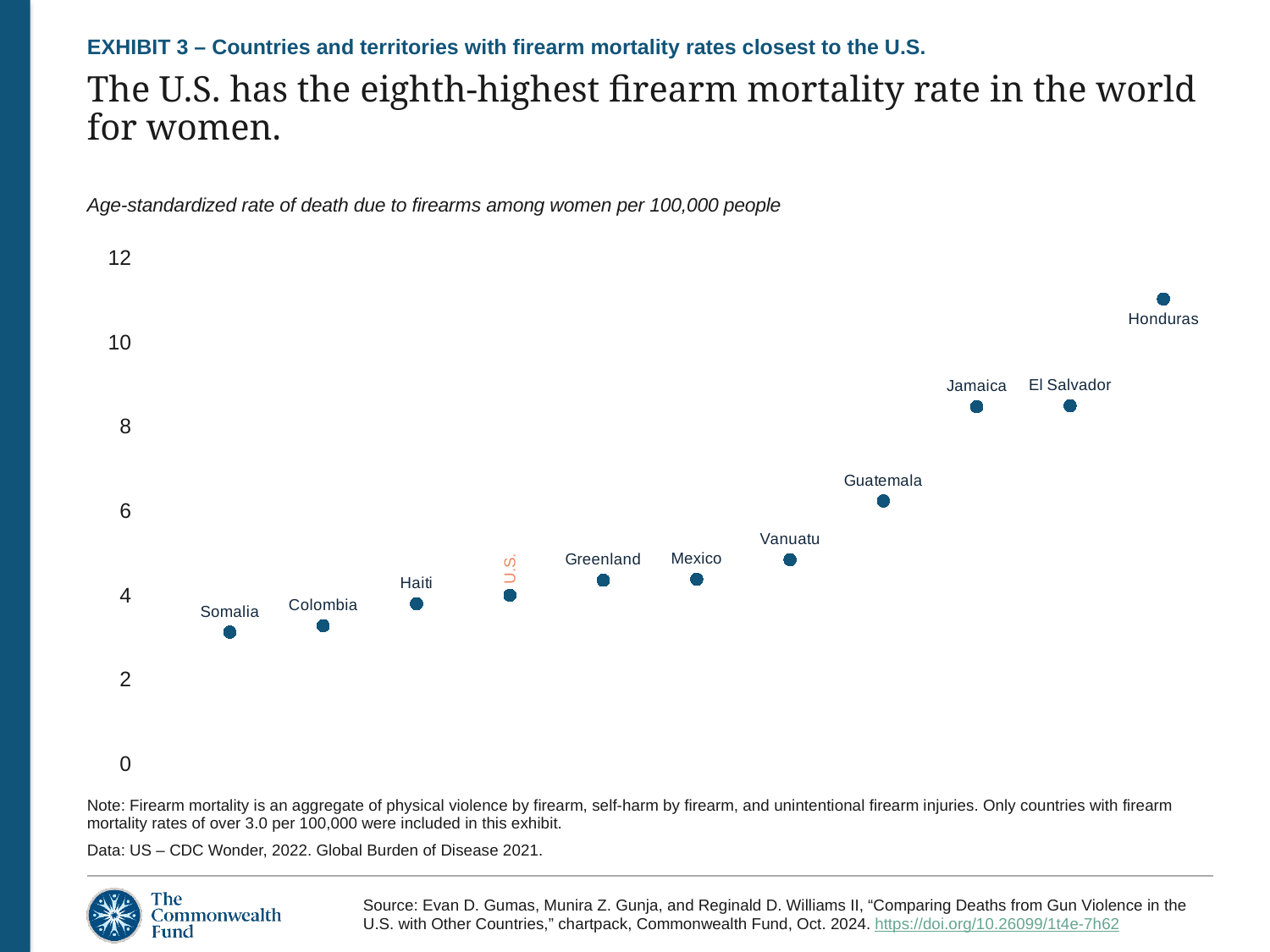
Is the value for Guatemala greater or less than 8? less Which country has the highest firearm mortality rate for women on the chart? Honduras Which has a higher firearm mortality rate for women, Guatemala or Vanuatu? Guatemala What kind of chart is shown on the slide? Scatter (dot) chart Which has a higher firearm mortality rate for women, Jamaica or Colombia? Jamaica How many countries and territories are plotted on the chart? 11 Is the value for Somalia greater or less than 4? less Is the value for Honduras greater or less than 10? greater What is the highest tick value shown on the vertical axis? 12 Do the plotted values rise or fall moving from left to right across the chart? Rise